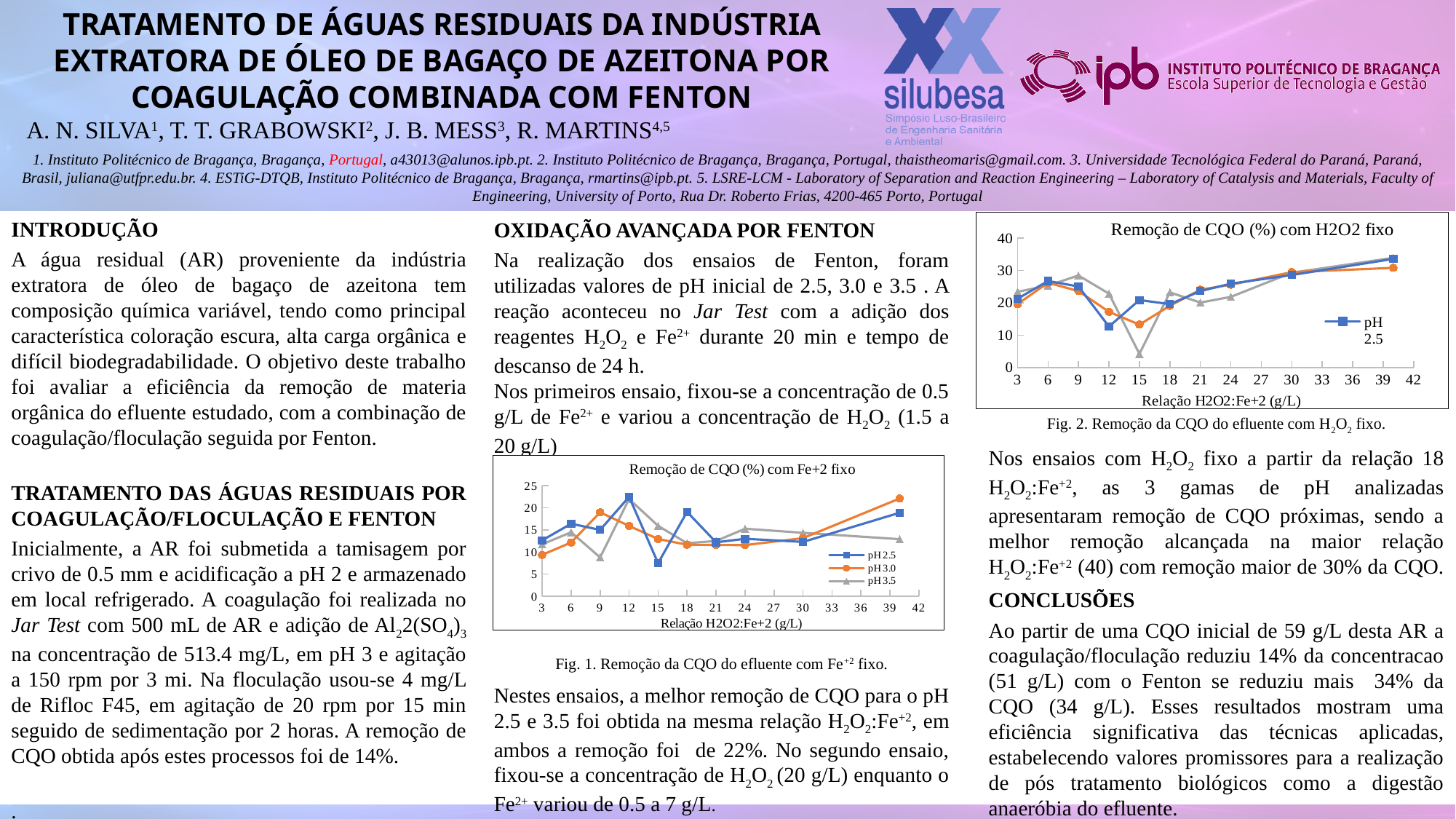
In the chart titled "Remoção de CQO (%) com H2O2 fixo", do the values for pH 2.5 rise or fall from relação 18 to relação 40? rise How many series does the legend of the chart titled "Remoção de CQO (%) com Fe+2 fixo" list? 3 In the chart titled "Remoção de CQO (%) com Fe+2 fixo", at which relação value does the pH 2.5 series reach its lowest point? 15 In the chart titled "Remoção de CQO (%) com Fe+2 fixo", at relação 15, which series has the larger value: pH 2.5 or pH 3.5? pH 3.5 In the chart titled "Remoção de CQO (%) com H2O2 fixo", is the value for pH 3.5 at relação 15 greater or less than 10? less In the chart titled "Remoção de CQO (%) com H2O2 fixo", is the value for pH 2.5 at relação 40 greater or less than 30? greater In the chart titled "Remoção de CQO (%) com H2O2 fixo", at relação 15, which series has the larger value: pH 2.5 or pH 3.5? pH 2.5 In the chart titled "Remoção de CQO (%) com Fe+2 fixo", is the value for pH 2.5 at relação 15 greater or less than 10? less What kind of chart is the chart titled "Remoção de CQO (%) com Fe+2 fixo"? line chart What is the x-axis title of the chart titled "Remoção de CQO (%) com H2O2 fixo"? Relação H2O2:Fe+2 (g/L)